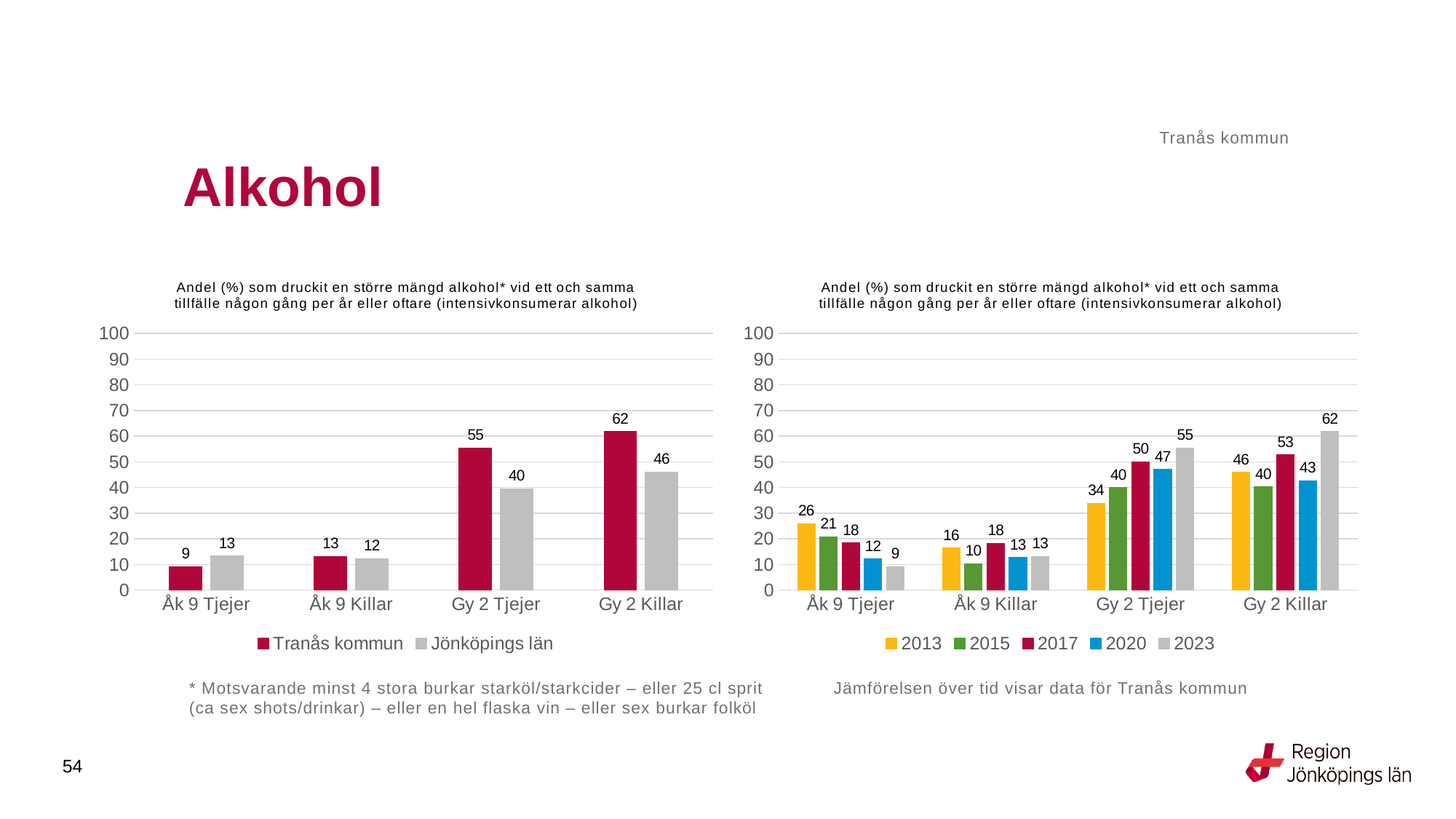
In the right chart, which is larger for Gy 2 Tjejer: the value for 2015 or the value for 2017? 2017 What kind of chart is the left chart? bar chart In the right chart, what is the value for 2013 for Åk 9 Tjejer? 26 In the left chart, what is the value for Jönköpings län for Gy 2 Tjejer? 40 In the right chart, which year has the highest value for Gy 2 Killar? 2023 In the right chart, what is the value for 2020 for Gy 2 Killar? 43 In the left chart, what is the value for Tranås kommun for Gy 2 Killar? 62 In the right chart, do the values for Åk 9 Tjejer rise or fall from 2013 to 2023? fall In the left chart, which category has the lowest value for Tranås kommun? Åk 9 Tjejer In the right chart, how many series does the legend list? 5 In the left chart, what is the difference between Tranås kommun and Jönköpings län for Gy 2 Tjejer? 15 In the left chart, how many series does the legend list? 2